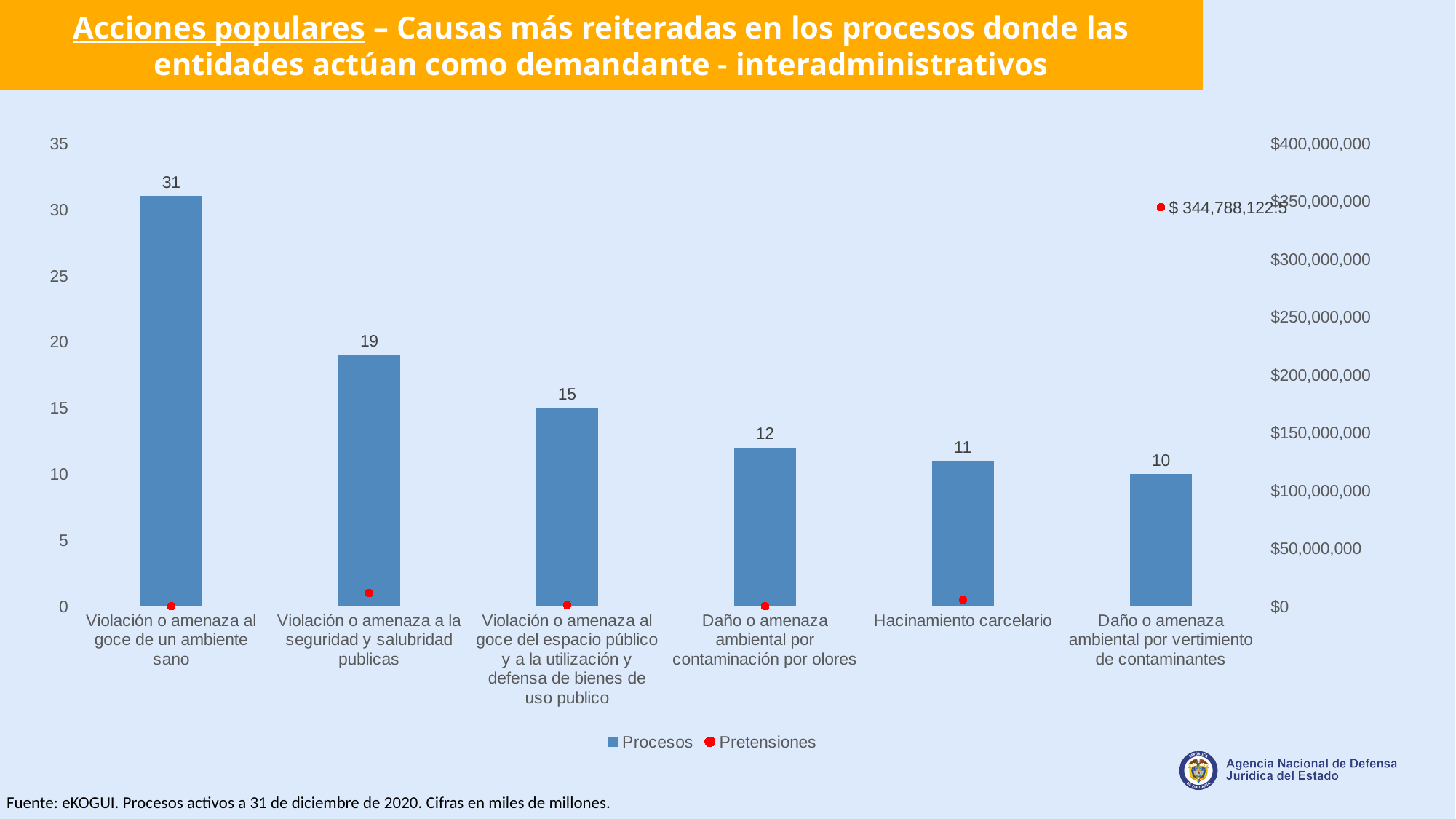
How many categories are shown on the x axis of the chart? 6 Which series is shown with red dots in the chart? Pretensiones What is the Procesos value for 'Hacinamiento carcelario'? 11 What is the difference in Procesos between 'Violación o amenaza al goce de un ambiente sano' and 'Violación o amenaza a la seguridad y salubridad publicas'? 12 What is the Procesos value for 'Violación o amenaza al goce de un ambiente sano'? 31 Is the Pretensiones value for 'Daño o amenaza ambiental por vertimiento de contaminantes' greater or less than $300,000,000? greater How many series does the legend list? 2 What is the Procesos value for 'Daño o amenaza ambiental por contaminación por olores'? 12 Which has more Procesos: 'Violación o amenaza al goce del espacio público y a la utilización y defensa de bienes de uso publico' or 'Hacinamiento carcelario'? Violación o amenaza al goce del espacio público y a la utilización y defensa de bienes de uso publico Which category has the lowest number of Procesos? Daño o amenaza ambiental por vertimiento de contaminantes Which category has the highest number of Procesos? Violación o amenaza al goce de un ambiente sano Do the Procesos values rise or fall from left to right along the x axis? fall